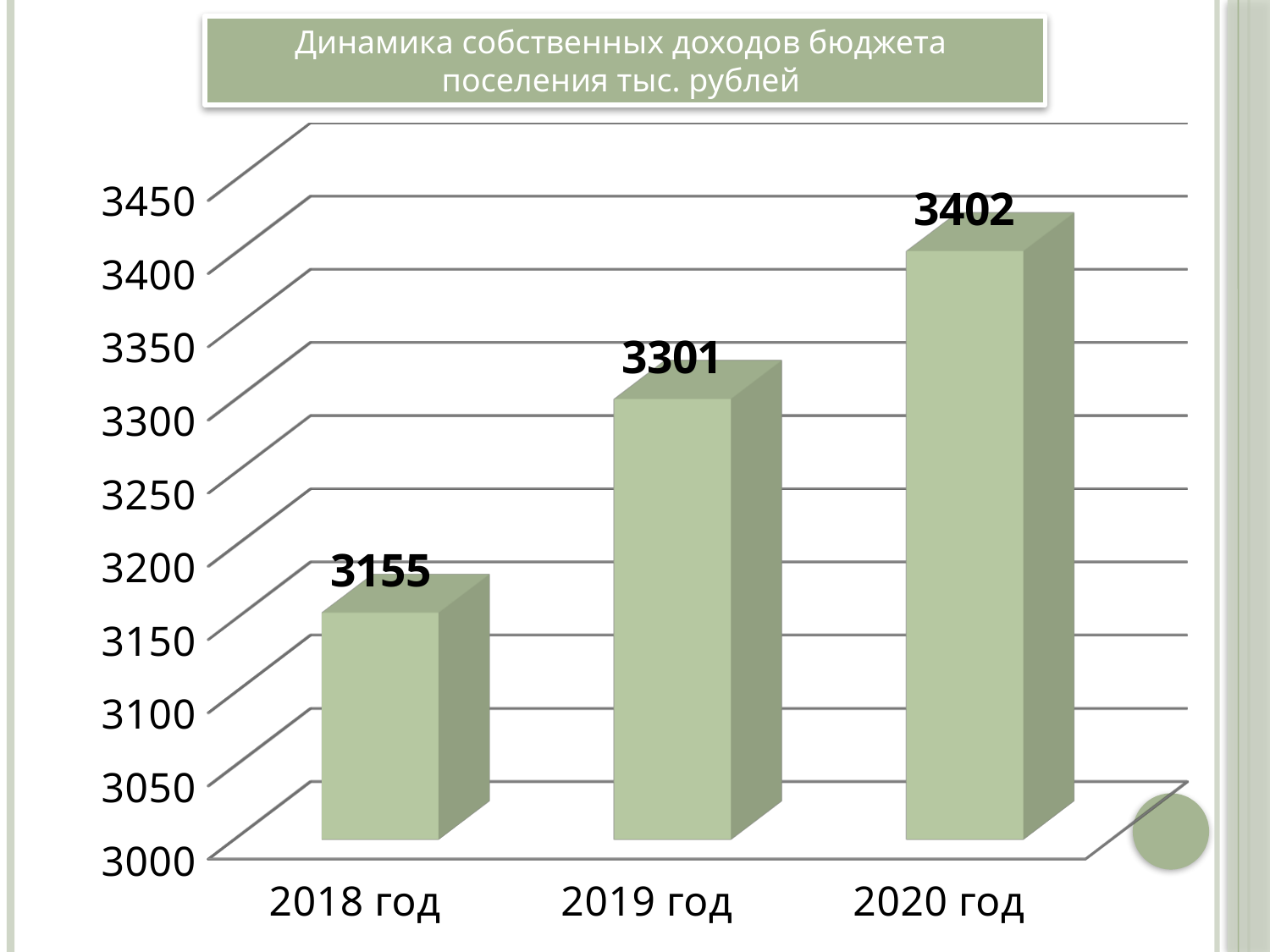
What is the value for 2020 год? 3402 Which is larger, the value for 2019 год or the value for 2020 год? 2020 год Is the value for 2019 год greater or less than 3250? greater Which year has the lowest value? 2018 год How many categories are shown on the x axis? 3 What is the value for 2019 год? 3301 What kind of chart is shown on the slide? bar chart What is the value for 2018 год? 3155 Which year has the highest value? 2020 год What is the difference between the values for 2019 год and 2018 год? 146 Do the values rise or fall from 2018 год to 2020 год? rise What is the difference between the values for 2020 год and 2018 год? 247